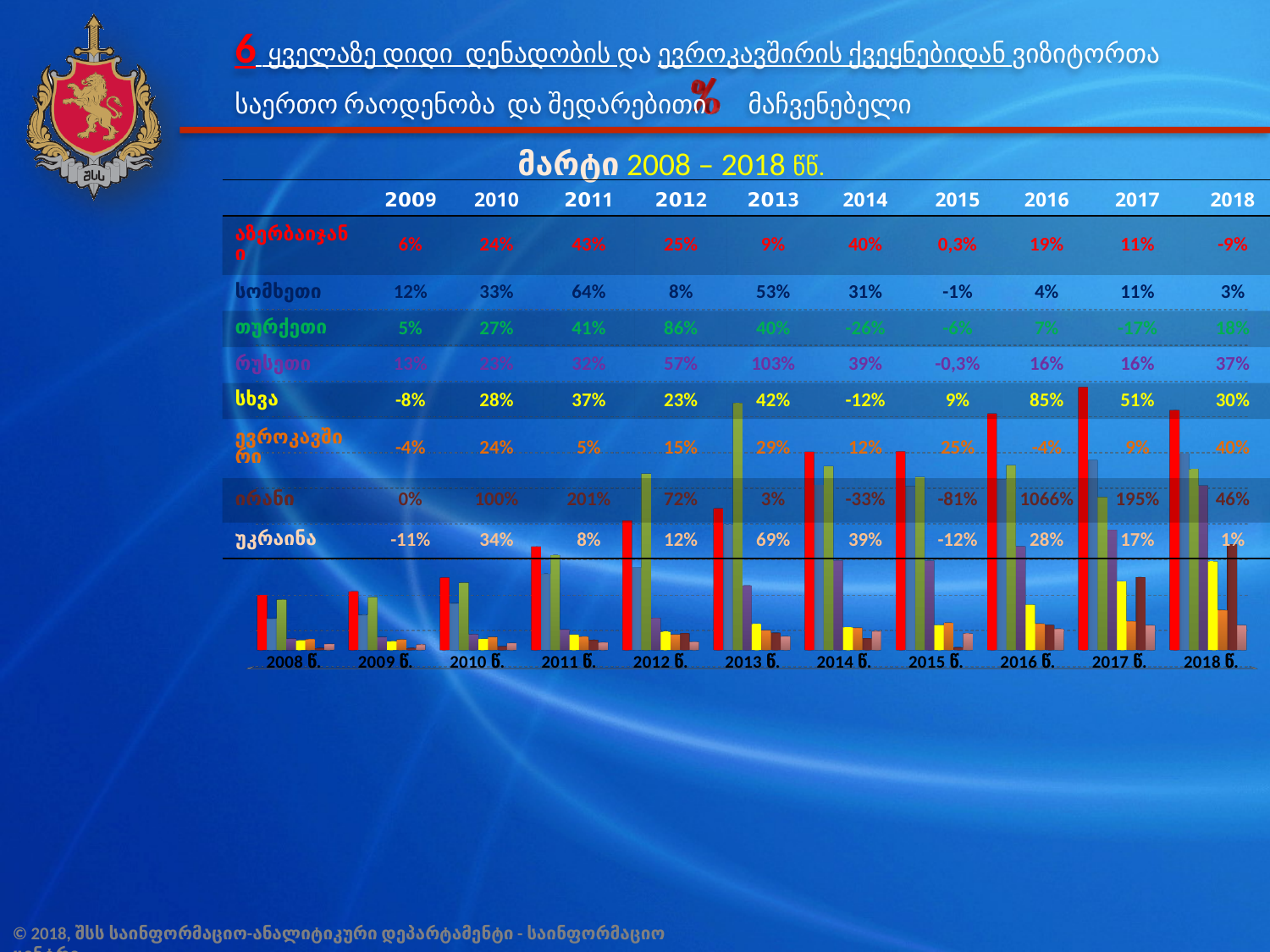
What is the first year label on the chart's x axis? 2008 წ. What is the last year label on the chart's x axis? 2018 წ. In which year is the red bar the tallest? 2017 წ. Do the red bars generally rise or fall from 2008 to 2017? rise Is the yellow bar taller in 2017 or in 2018? 2018 How many years are shown along the x axis of the chart? 11 What kind of chart is shown on the slide? bar chart Is the green bar taller in 2013 or in 2014? 2013 Is the red bar taller in 2008 or in 2018? 2018 In which year is the green bar the tallest? 2013 წ.